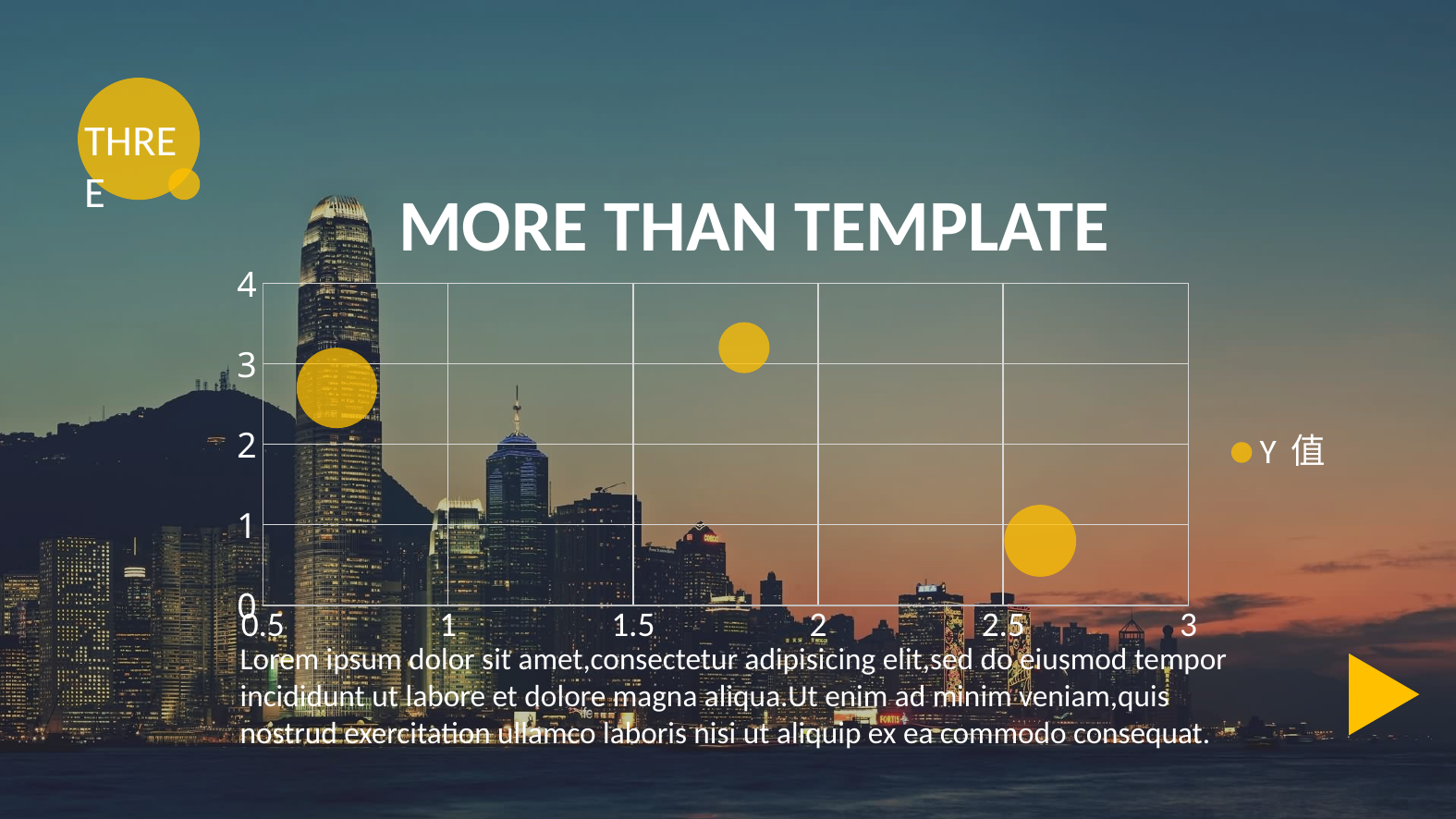
Is the y value of the bubble located near x = 0.5 greater or less than 3? less Is the y value of the bubble located near x = 2.5 greater or less than 1? less Which bubble has the lowest y value: the one near x = 0.5, the one between x = 1.5 and 2, or the one near x = 2.5? The one near x = 2.5 Is the y value of the bubble located near x = 0.5 greater or less than 2? greater Which bubble is the smallest in size: the one near x = 0.5, the one between x = 1.5 and 2, or the one near x = 2.5? The one between x = 1.5 and 2 How many series does the chart legend list? 1 Which bubble has the highest y value: the one near x = 0.5, the one between x = 1.5 and 2, or the one near x = 2.5? The one between x = 1.5 and 2 How many bubbles are plotted on the chart? 3 What kind of chart is shown on the slide? Bubble chart What is the maximum value shown on the chart's vertical axis? 4 What is the name of the series shown in the chart legend? Y 值